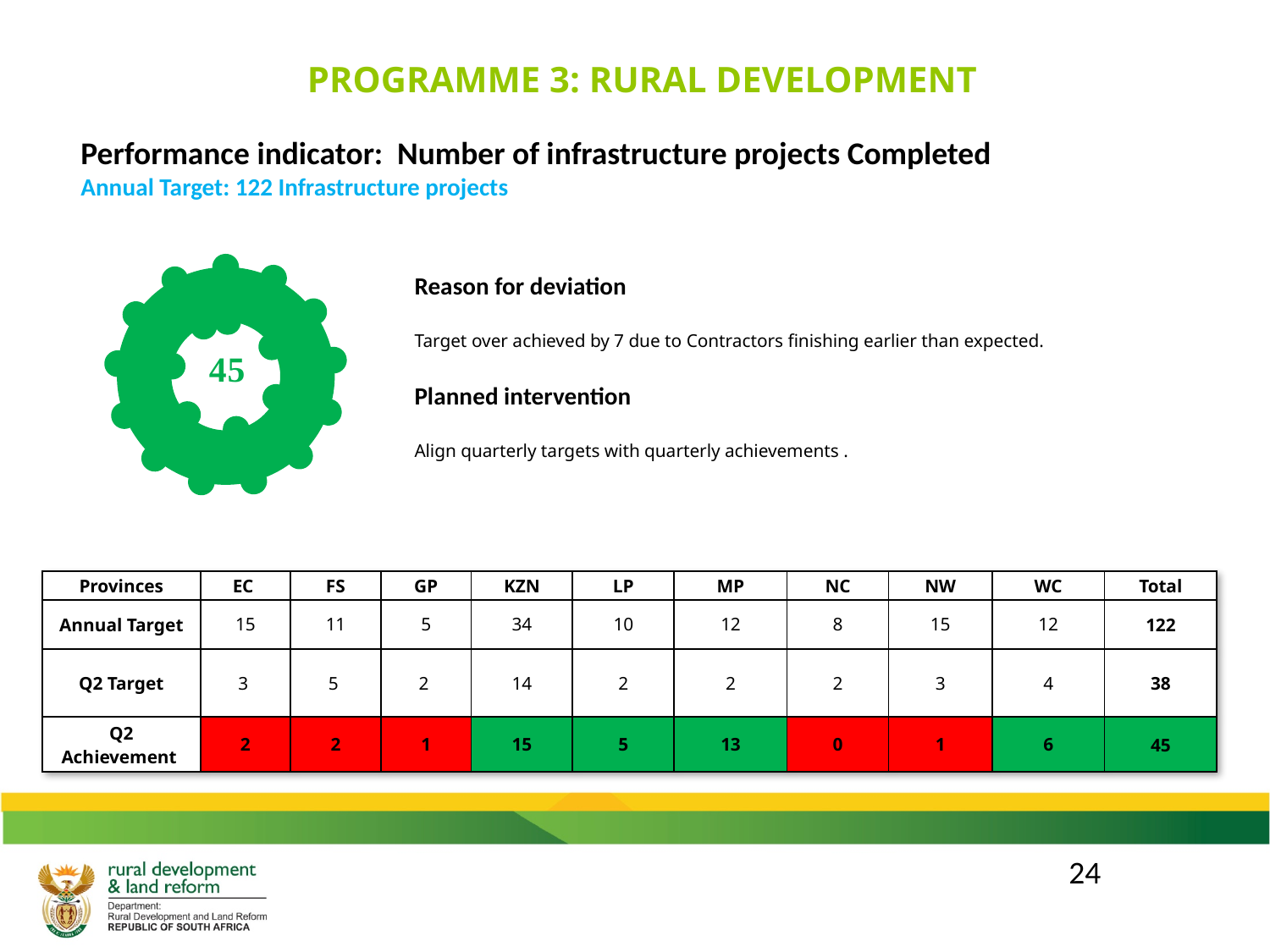
What colour is the ring of the doughnut chart on the left of the slide? green What value is displayed in the centre of the green ring chart on the left of the slide? 45 What kind of chart is shown on the left of the slide, with the number 45 in its centre? doughnut chart